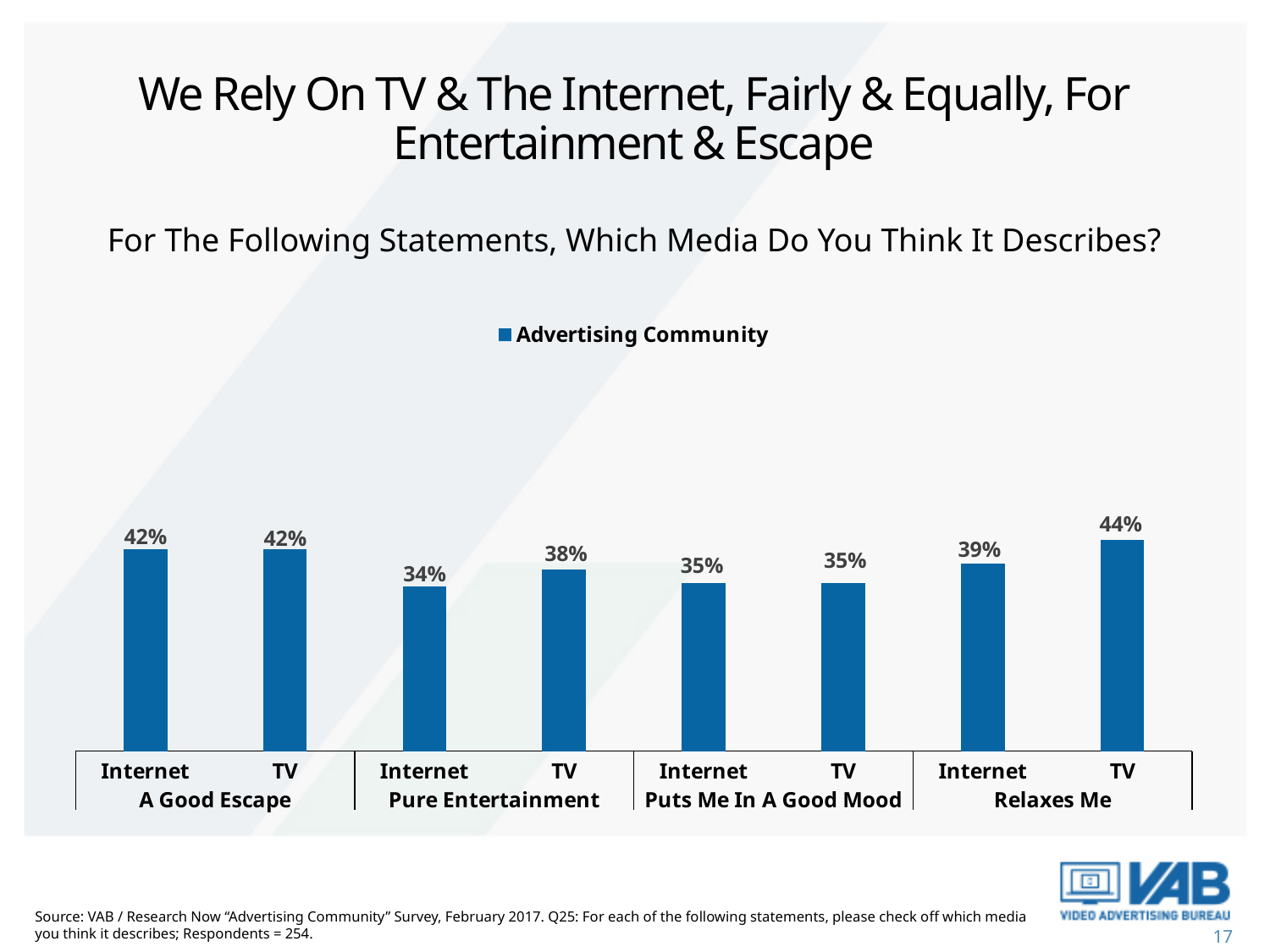
What is the difference between TV and Internet under "Pure Entertainment"? 4% What is the difference between TV and Internet under "Relaxes Me"? 5% What series does the legend list? Advertising Community What is the value for TV under "Pure Entertainment"? 38% Which bar has the lowest value on the chart? Internet, Pure Entertainment (34%) What is the value for TV under "Puts Me In A Good Mood"? 35% How many bars are plotted on the chart? 8 Under "Relaxes Me", which is larger, Internet or TV? TV Which bar has the highest value on the chart? TV, Relaxes Me (44%) What is the value for Internet under "A Good Escape"? 42% What is the value for Internet under "Relaxes Me"? 39% What kind of chart is shown on the slide? Bar chart